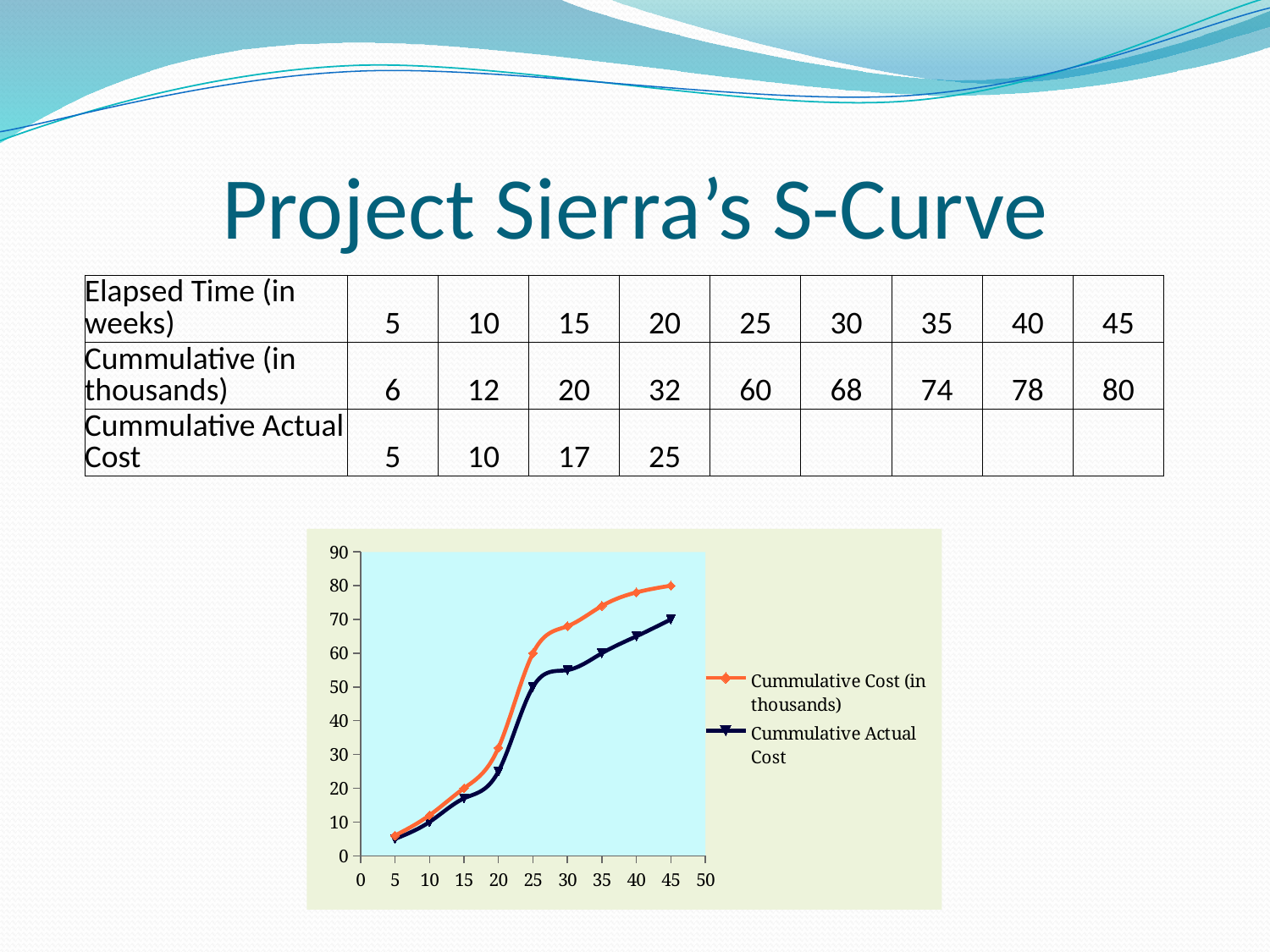
What is the Cummulative Cost (in thousands) at 45 weeks of elapsed time? 80 What is the Cummulative Cost (in thousands) at 25 weeks of elapsed time? 60 What is the Cummulative Actual Cost at 20 weeks of elapsed time? 25 What kind of chart is shown on the slide? line chart At which elapsed time is the Cummulative Cost (in thousands) lowest? 5 What is the difference between the Cummulative Cost (in thousands) at 25 weeks and at 20 weeks? 28 Is the Cummulative Actual Cost at 45 weeks greater or less than 60? greater How many series does the chart's legend list? 2 How many data points are plotted for the Cummulative Cost (in thousands) series? 9 Do the values of the Cummulative Cost (in thousands) series rise or fall as elapsed time increases? rise At 15 weeks, which series has the larger value: Cummulative Cost (in thousands) or Cummulative Actual Cost? Cummulative Cost (in thousands) At which elapsed time is the Cummulative Cost (in thousands) highest? 45